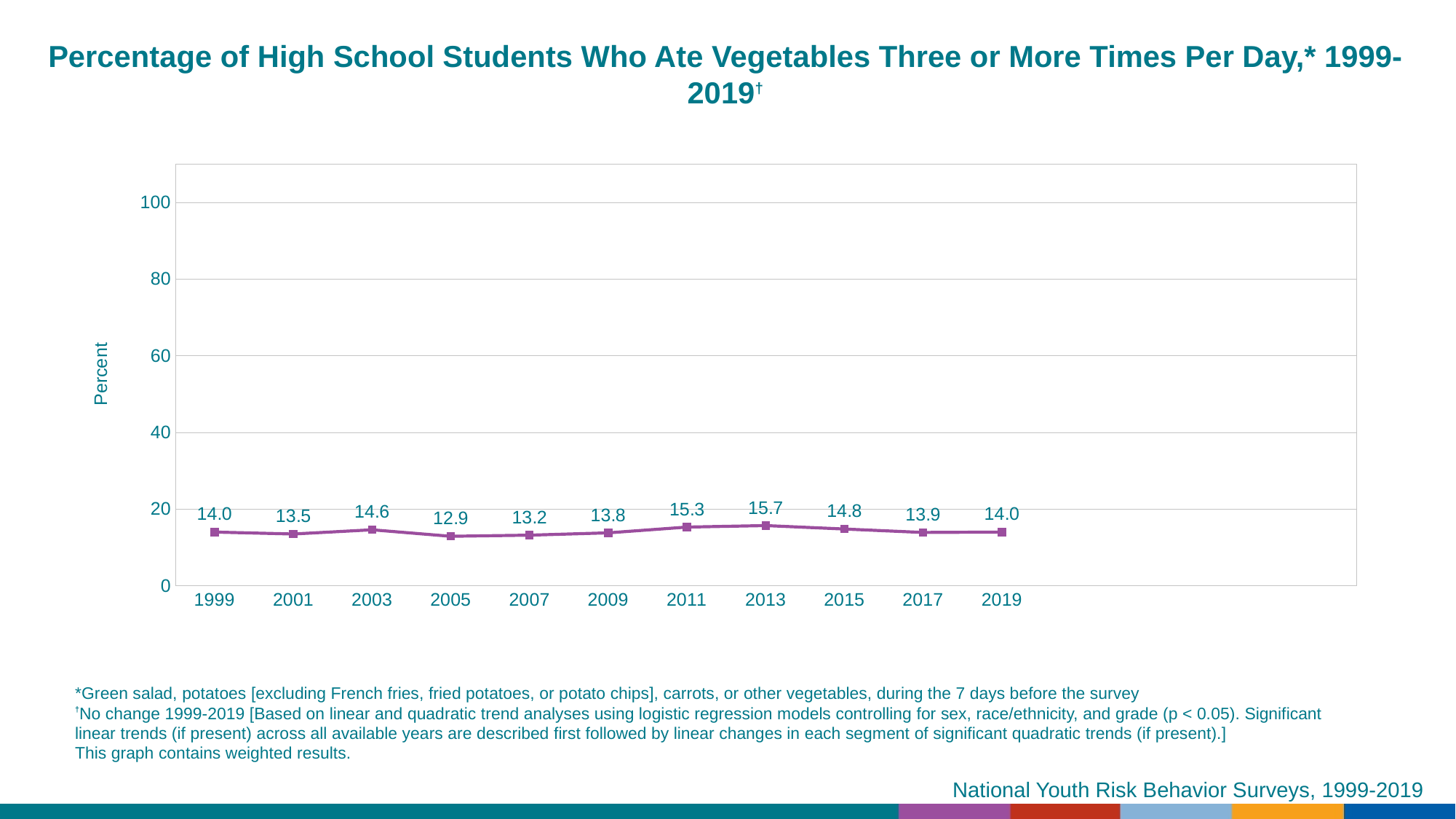
Which year has the lowest percentage? 2005 What is the label on the vertical axis? Percent What is the difference between the 2013 value and the 2005 value? 2.8 How many years are plotted on the chart? 11 What percentage of high school students ate vegetables three or more times per day in 2013? 15.7 What is the value plotted for 2005? 12.9 Is the value for 2013 greater or less than 20? less Which year has a larger value, 2003 or 2017? 2003 Which year has the highest percentage? 2013 What is the value plotted for 1999? 14.0 What kind of chart is shown on the slide? line chart What is the difference between the 2011 value and the 2009 value? 1.5